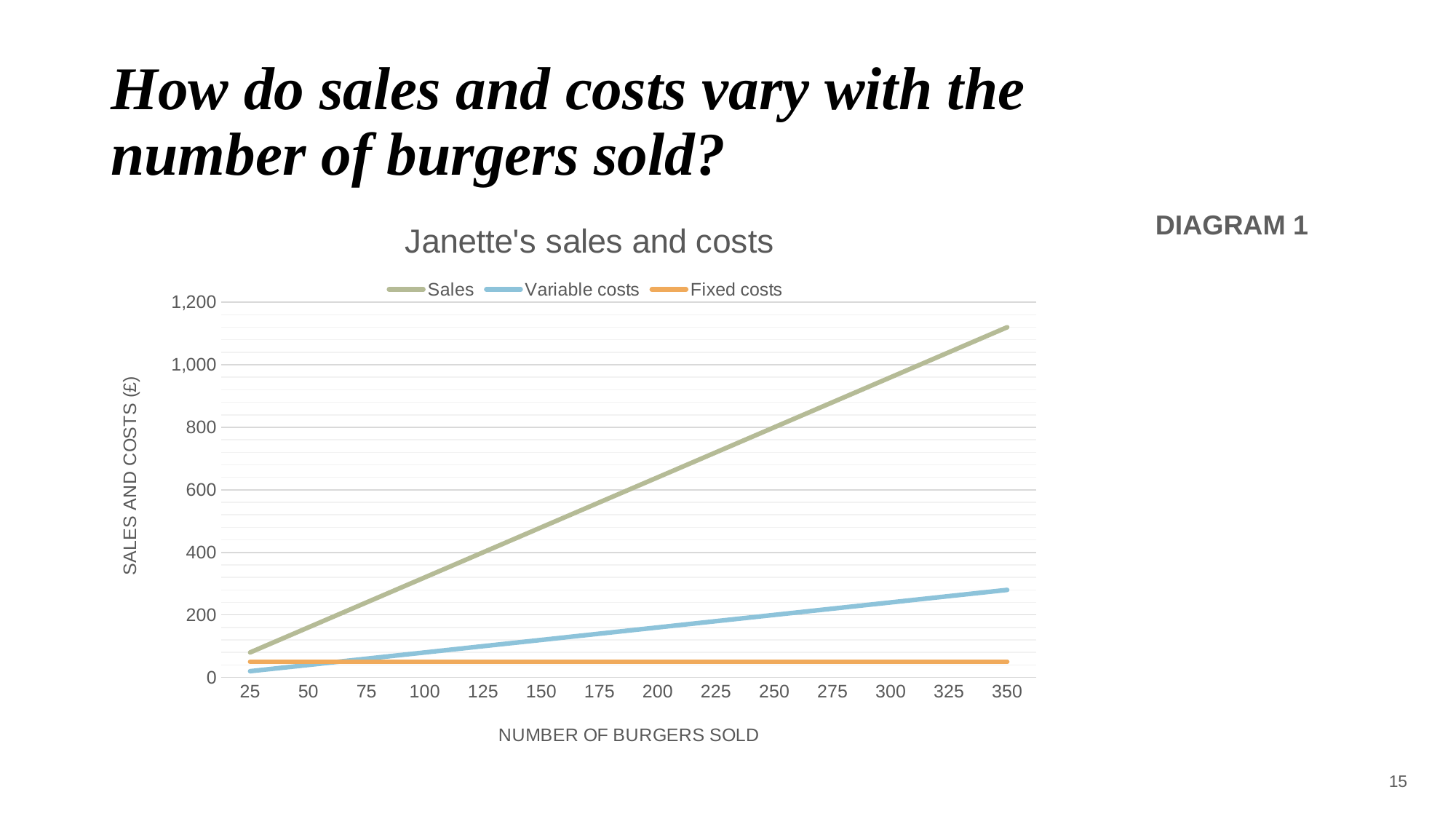
At 350 burgers sold, which is larger: Sales or Variable costs? Sales Is the value for Variable costs at 350 burgers greater or less than 400? less How many series does the legend list? 3 Does the Fixed costs line rise, fall or stay flat as the number of burgers sold increases? Stays flat Is the value for Sales at 300 burgers greater or less than 800? greater How many points are marked along the x axis (number of burgers sold)? 14 Does the Sales line rise or fall as the number of burgers sold increases? Rises What is the label of the y axis? SALES AND COSTS (£) At 25 burgers sold, which is larger: Fixed costs or Variable costs? Fixed costs Is the value for Sales at 350 burgers greater or less than 1,000? greater What kind of chart is shown on the slide? Line chart What is the title of the chart? Janette's sales and costs